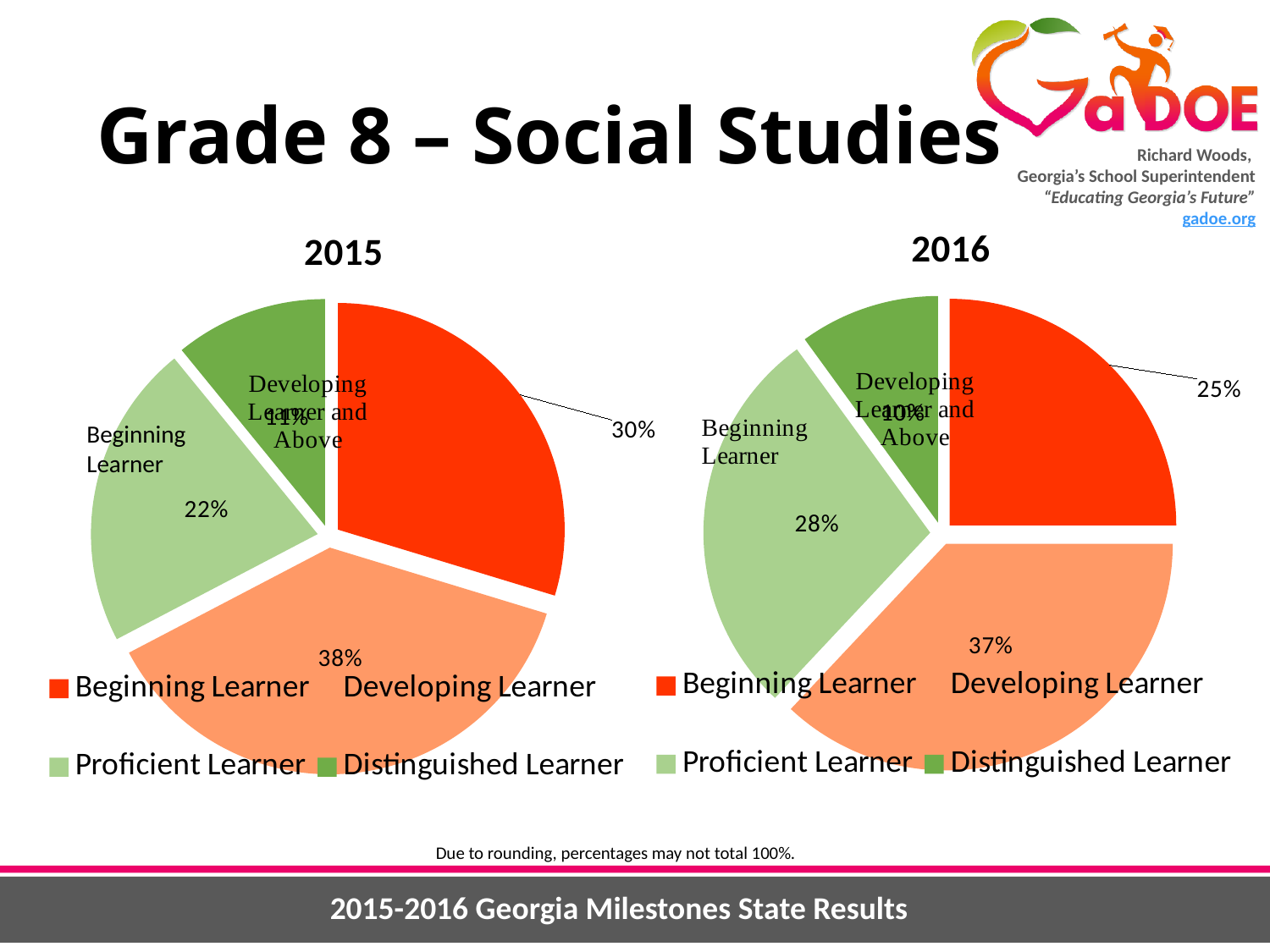
What is the difference between the Beginning Learner percentage in 2015 and in 2016? 5% In the 2015 pie chart, what percentage is shown for Distinguished Learner? 11% In the 2016 pie chart, what percentage is shown for Beginning Learner? 25% In the 2016 pie chart, which category has the smallest share? Distinguished Learner What is the difference between the Developing Learner and Proficient Learner percentages in the 2016 pie chart? 9% What colour represents Beginning Learner in the legend? Red In the 2015 pie chart, what percentage is shown for Developing Learner? 38% What type of chart is used on this slide? Pie chart In the 2016 pie chart, what percentage is shown for Proficient Learner? 28% Which is larger: the Proficient Learner share in 2015 or in 2016? 2016 In the 2015 pie chart, which category has the largest share? Developing Learner How many categories does each pie chart show? 4